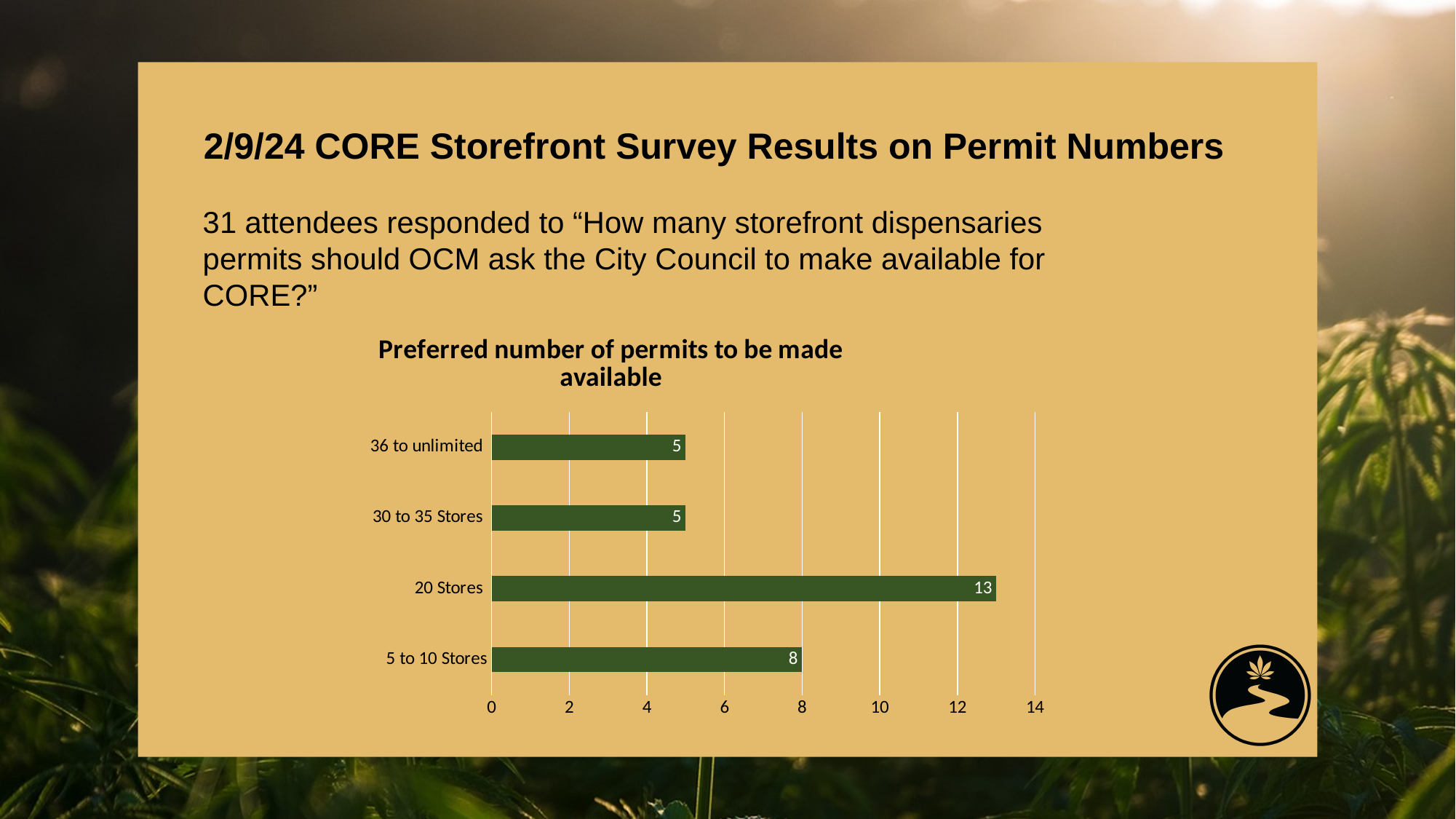
What is the title of the chart? Preferred number of permits to be made available Which is larger, the value for 20 Stores or the value for 5 to 10 Stores? 20 Stores What is the value for 36 to unlimited? 5 How many categories are shown in the chart? 4 What is the value for 20 Stores? 13 Is the value for 20 Stores greater or less than 12? greater What is the difference between the values for 5 to 10 Stores and 30 to 35 Stores? 3 What is the value for 5 to 10 Stores? 8 What kind of chart is shown on the slide? bar chart What is the value for 30 to 35 Stores? 5 Which category has the highest value? 20 Stores What is the difference between the values for 20 Stores and 5 to 10 Stores? 5